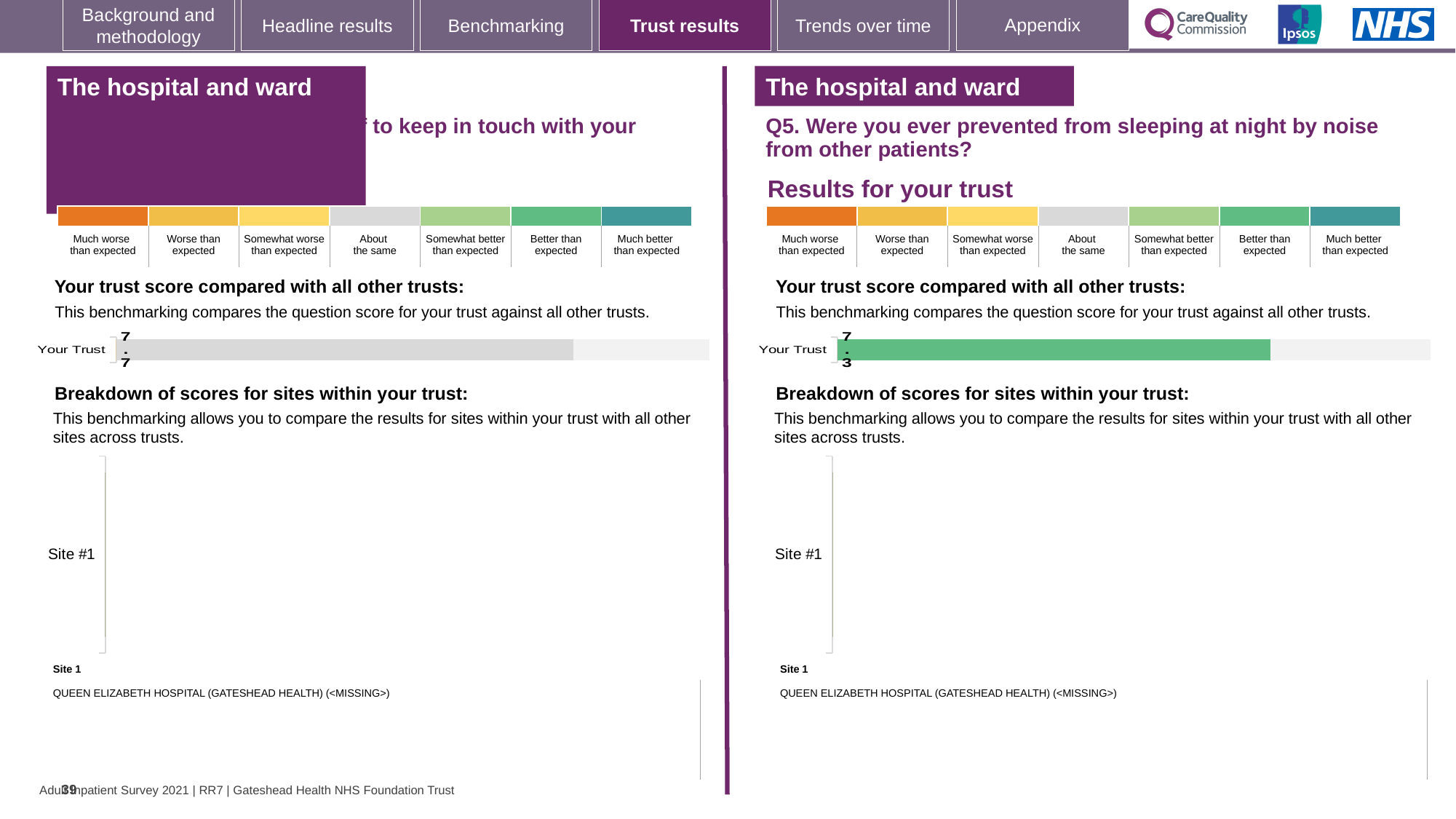
What colour is the 'Your Trust' bar in the right-hand panel (Q5) chart? Green In the 'Your Trust' chart on the left-hand panel, what is the trust score? 7.7 Which 'Your Trust' score is larger: the one on the left-hand panel or the one on the right-hand panel (Q5)? Left-hand panel (7.7) What is the difference between the 'Your Trust' score on the left-hand panel (7.7) and the one on the right-hand panel for Q5 (7.3)? 0.4 How many rating categories are shown in the colour key above the 'Your Trust' chart on the right-hand panel (Q5)? 7 In the 'Your Trust' chart on the right-hand panel (Q5, prevented from sleeping at night by noise from other patients), what is the trust score? 7.3 How many bars are plotted in the 'Your Trust' chart on the right-hand panel (Q5)? 1 What kind of chart is used to show the 'Your Trust' score on the right-hand panel (Q5)? Bar chart